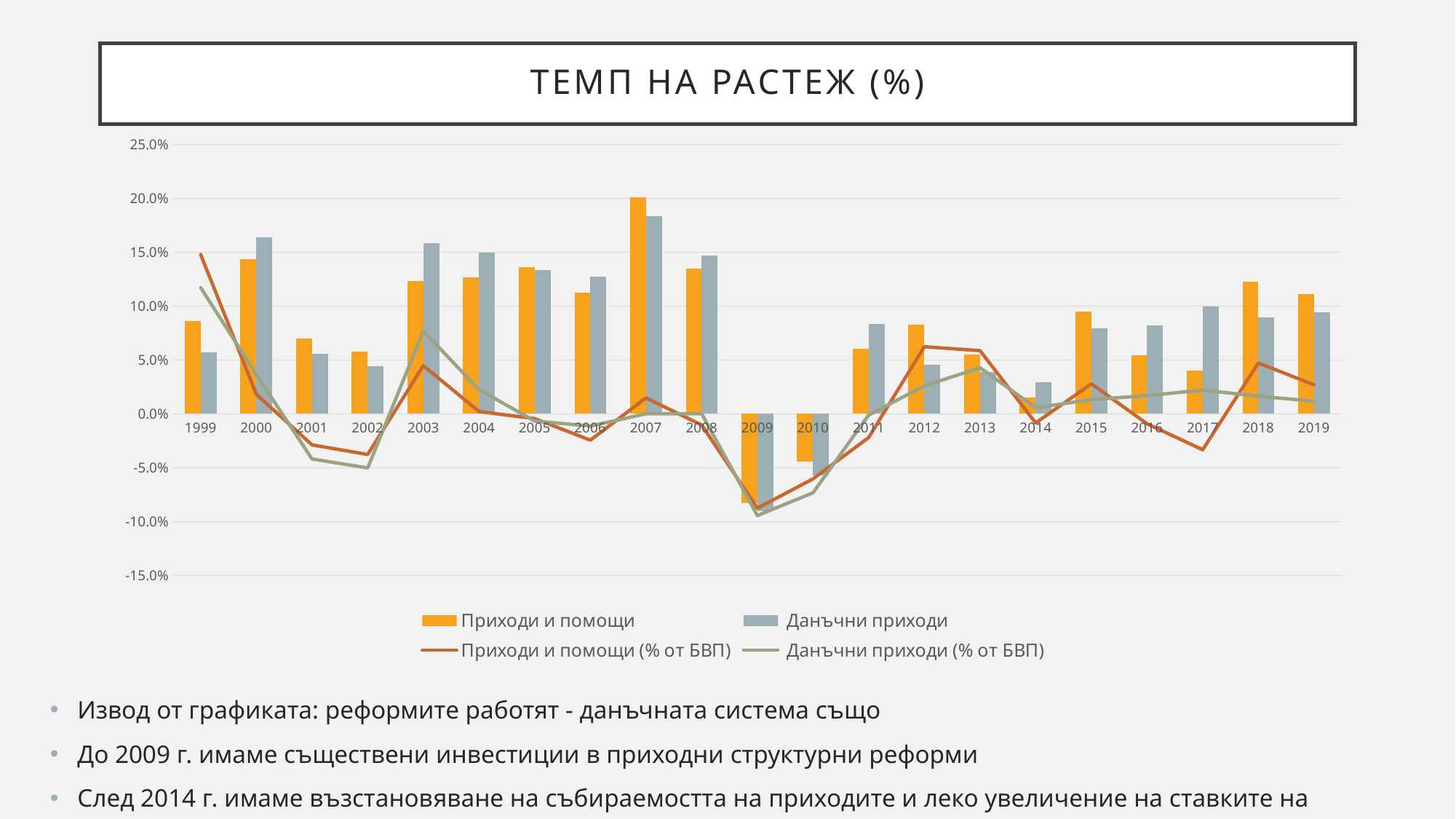
What kind of chart is shown on the slide? Combined bar and line chart In which year is the 'Приходи и помощи' bar the highest? 2007 In 2015, which bar is taller: 'Приходи и помощи' or 'Данъчни приходи'? Приходи и помощи Is the 'Приходи и помощи' value for 2001 greater or less than 10.0%? less In 2017, which bar is taller: 'Приходи и помощи' or 'Данъчни приходи'? Данъчни приходи Is the 'Приходи и помощи' value for 2007 greater or less than 15.0%? greater How many years are shown on the x axis? 21 What is the title of the chart? ТЕМП НА РАСТЕЖ (%) In which year is the 'Данъчни приходи' bar the lowest? 2009 Is the 'Данъчни приходи' value for 2009 greater or less than -5.0%? less Do the 'Приходи и помощи' bars rise or fall from 2007 to 2009? fall How many series does the legend list? 4